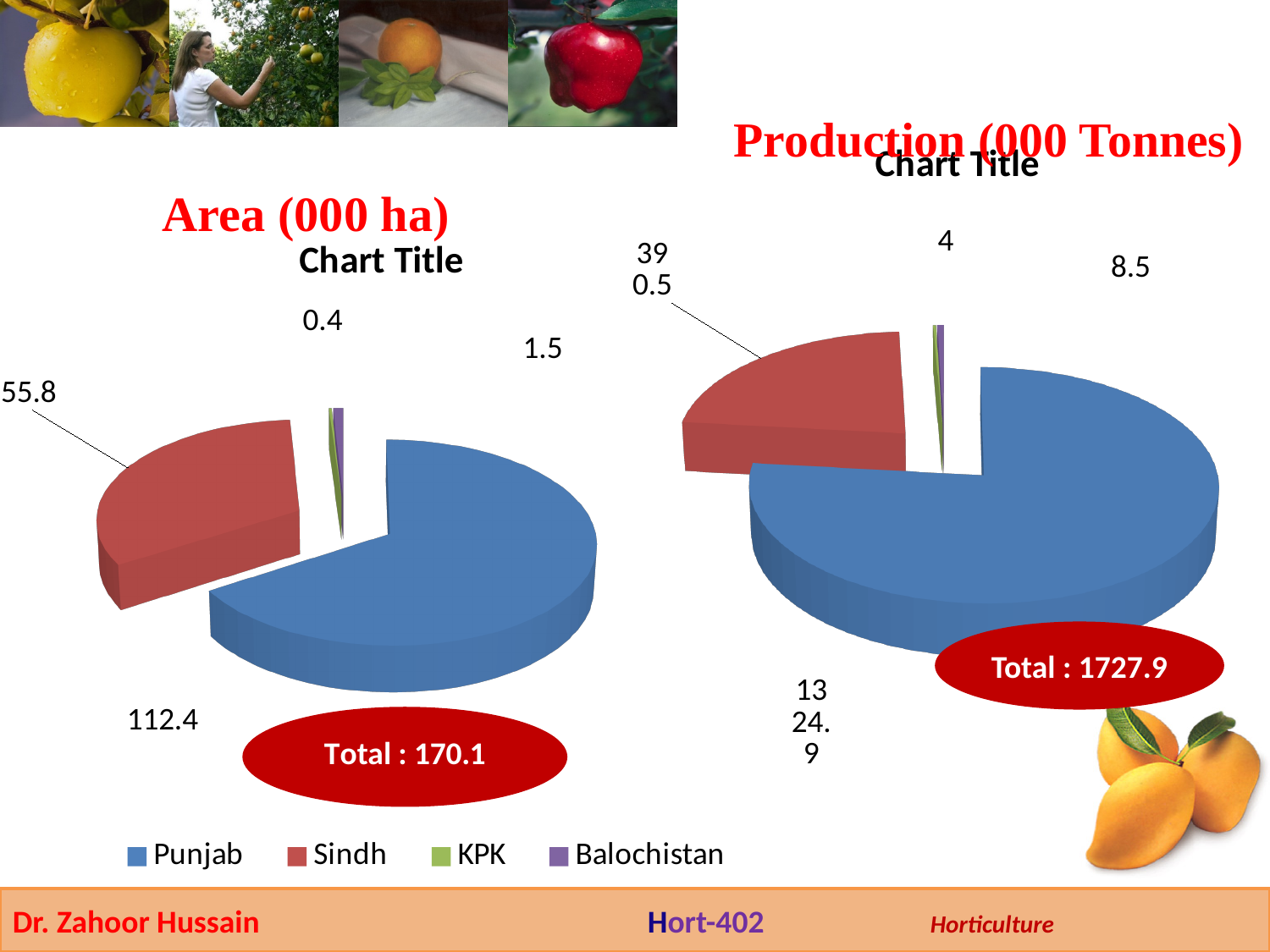
In the Area (000 ha) pie chart, what is the value for KPK? 0.4 In the Area (000 ha) pie chart, what is the value for Punjab? 112.4 In the Area (000 ha) pie chart, what is the value for Sindh? 55.8 In the Area (000 ha) pie chart, what is the difference between the Punjab and Sindh values? 56.6 In the Production (000 Tonnes) pie chart, what is the value for KPK? 4 How many provinces are listed in the legend shared by the two pie charts? 4 What total is shown for the Production (000 Tonnes) chart? 1727.9 In the Area (000 ha) pie chart, which province has the smallest slice? KPK In the Area (000 ha) pie chart, which province has the largest slice? Punjab What total is shown for the Area (000 ha) chart? 170.1 In the Production (000 Tonnes) pie chart, what is the value for Balochistan? 8.5 In the Production (000 Tonnes) pie chart, which is larger, the Sindh slice or the Balochistan slice? Sindh